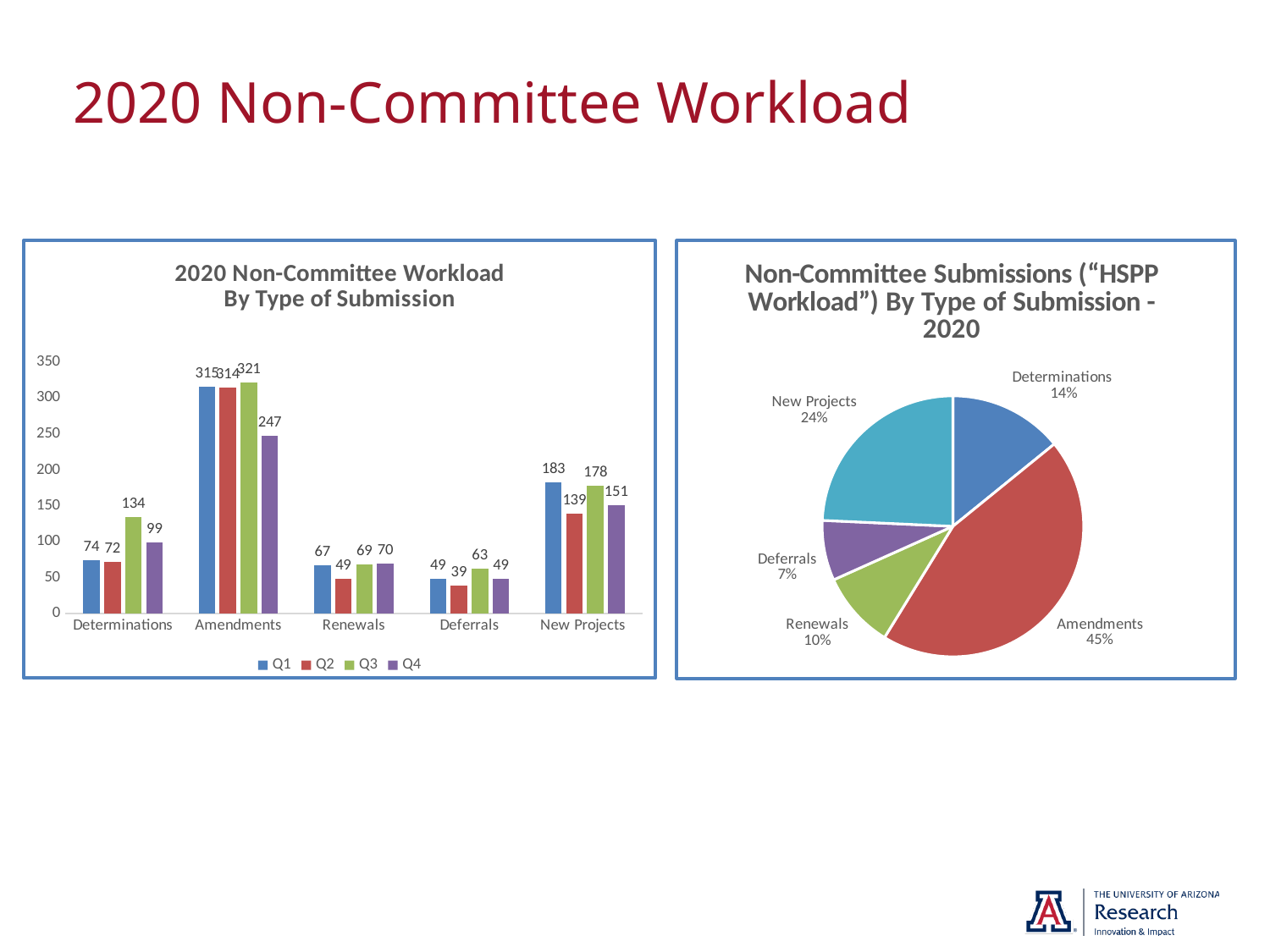
In the bar chart on the left, which submission type has the lowest Q2 value? Deferrals How many series does the legend of the bar chart on the left list? 4 In the bar chart on the left, what is the Q4 value for Amendments? 247 How many submission types are shown on the x axis of the bar chart on the left? 5 In the bar chart on the left, which is larger for Renewals: the Q1 value or the Q4 value? Q4 In the bar chart on the left, which submission type has the highest Q1 value? Amendments In the bar chart on the left, what is the Q3 value for Determinations? 134 In the pie chart on the right, which submission type has the smallest slice? Deferrals In the bar chart on the left, what is the difference between the Q1 and Q2 values for New Projects? 44 In the bar chart on the left, what is the Q2 value for New Projects? 139 In the pie chart on the right, what share do Amendments account for? 45% What kind of chart is the chart on the left? Bar chart